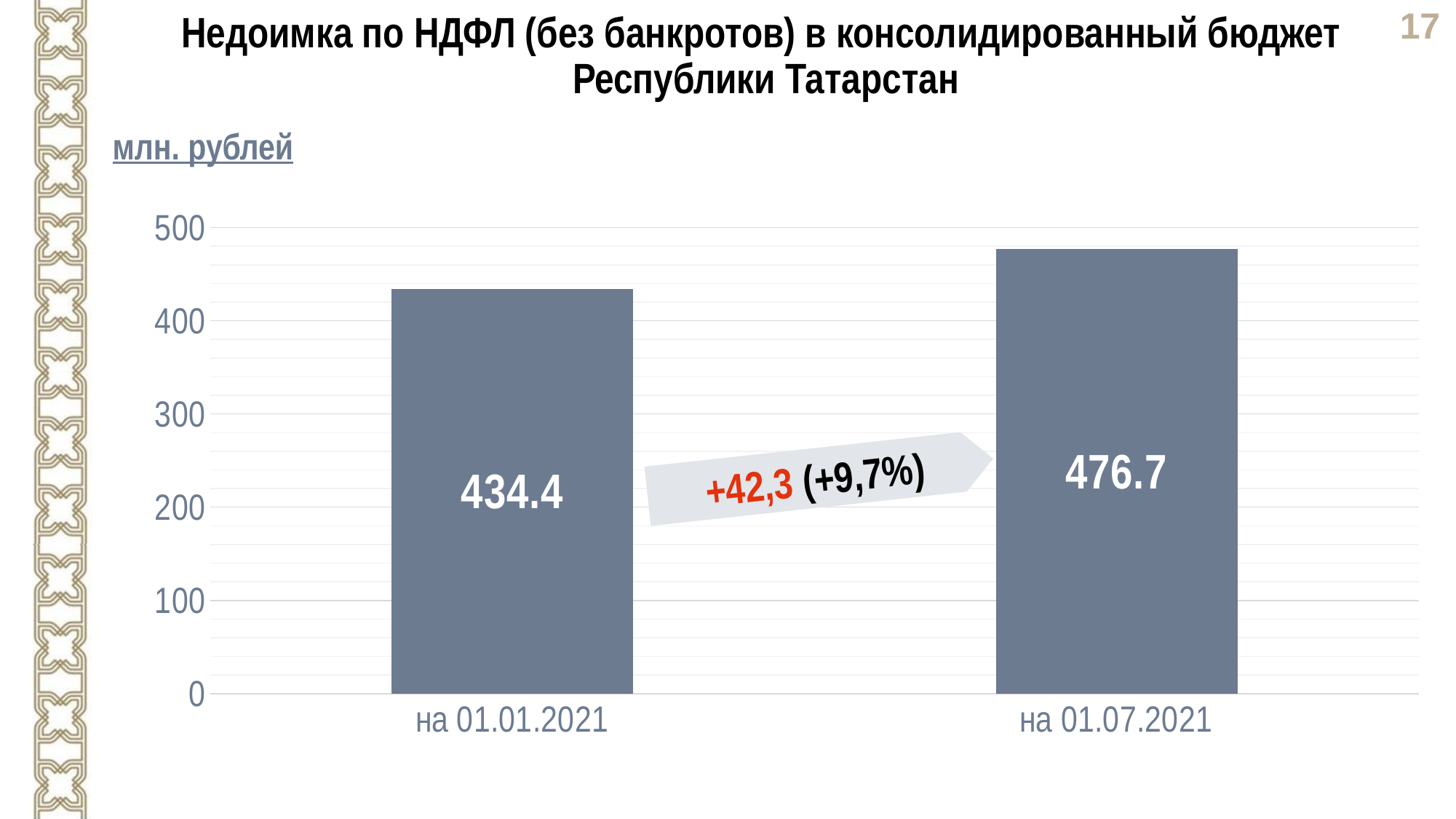
Is the value for на 01.07.2021 greater or less than 500? less Which is larger, the value for на 01.01.2021 or the value for на 01.07.2021? на 01.07.2021 Which category has the highest value? на 01.07.2021 What is the value for на 01.07.2021? 476.7 What is the value for на 01.01.2021? 434.4 How many categories are shown on the chart? 2 What unit of measurement is indicated above the chart? млн. рублей Which category has the lowest value? на 01.01.2021 What is the difference between the values for на 01.07.2021 and на 01.01.2021? 42.3 Is the value for на 01.01.2021 greater or less than 400? greater What kind of chart is shown on the slide? bar chart Do the values rise or fall from на 01.01.2021 to на 01.07.2021? rise